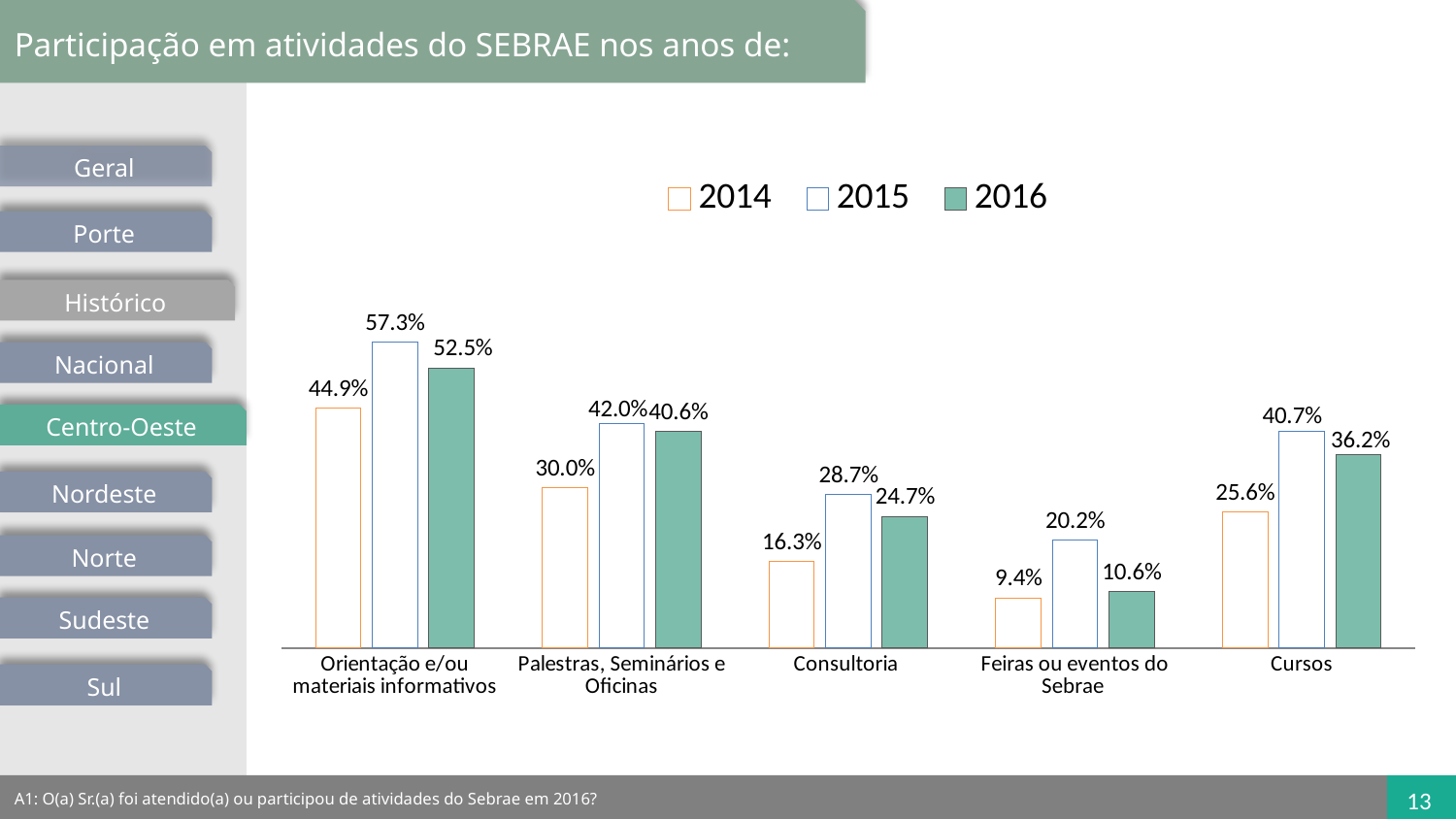
How many series does the legend list? 3 What is the 2014 value for Cursos? 25.6% Which series is shown with solid green bars? 2016 How many categories are shown on the x axis? 5 What is the 2016 value for Consultoria? 24.7% What is the 2015 value for Feiras ou eventos do Sebrae? 20.2% What is the difference between the 2015 and 2014 values for Palestras, Seminários e Oficinas? 12.0% Do the values for Orientação e/ou materiais informativos rise or fall from 2015 to 2016? Fall Which is larger for Cursos: the 2015 value or the 2016 value? 2015 Which category has the highest 2015 value? Orientação e/ou materiais informativos What kind of chart is shown on the slide? Bar chart Which category has the lowest 2014 value? Feiras ou eventos do Sebrae